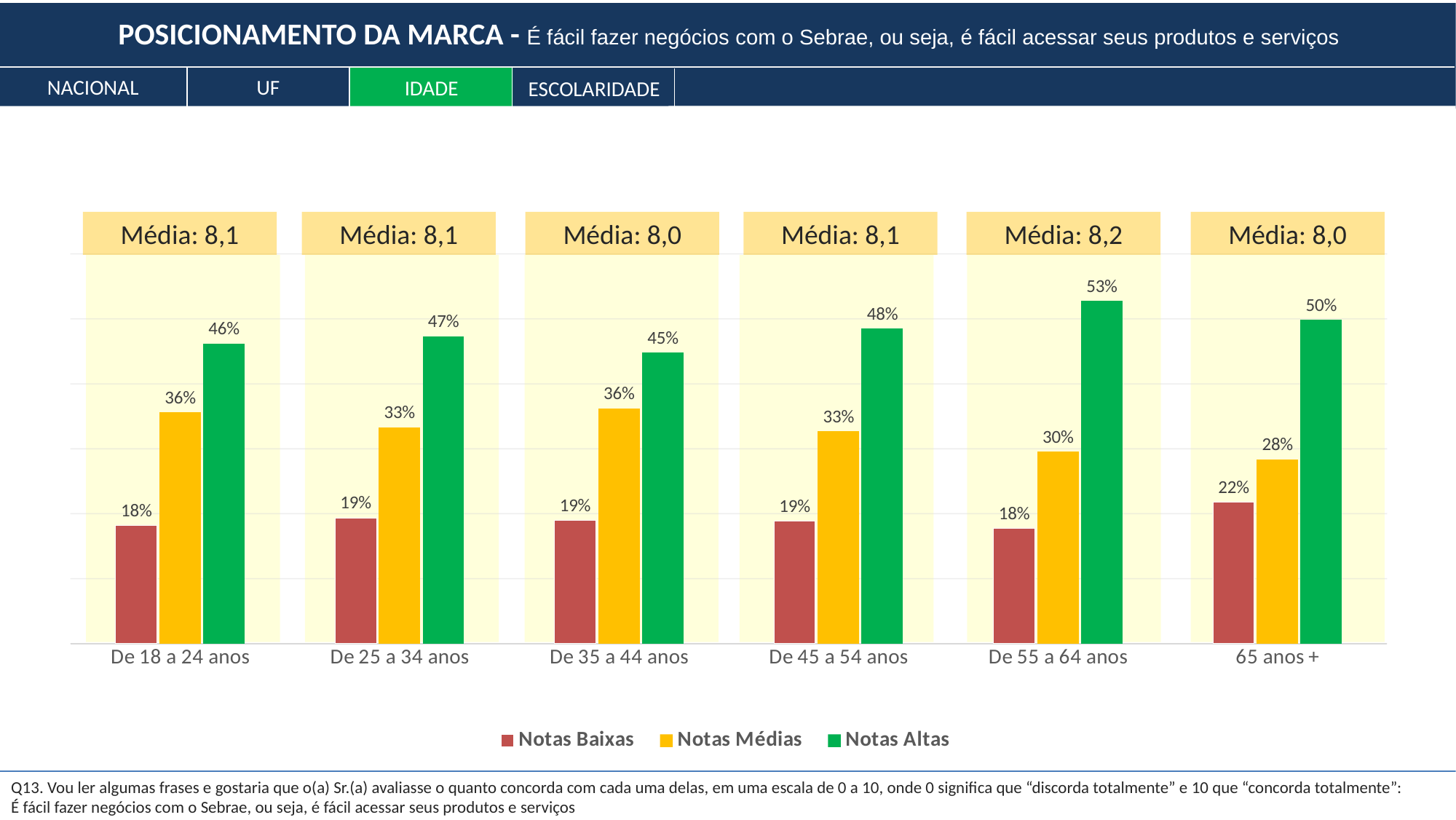
Which age group has the lowest Notas Médias value? 65 anos + What is the value of Notas Médias for the 'De 18 a 24 anos' age group? 36% What kind of chart is shown on the slide? Bar chart What is the difference between Notas Altas and Notas Baixas for the 'De 45 a 54 anos' age group? 29% How many series does the legend list? 3 What is the value of Notas Baixas for the '65 anos +' age group? 22% How many age groups are shown on the x axis? 6 What is the value of Notas Altas for the 'De 55 a 64 anos' age group? 53% Which is larger for the 'De 25 a 34 anos' group: Notas Médias or Notas Altas? Notas Altas What is the Média shown above the 'De 55 a 64 anos' age group? 8,2 Which age group has the highest Notas Altas value? De 55 a 64 anos Which colour represents Notas Altas in the legend? Green